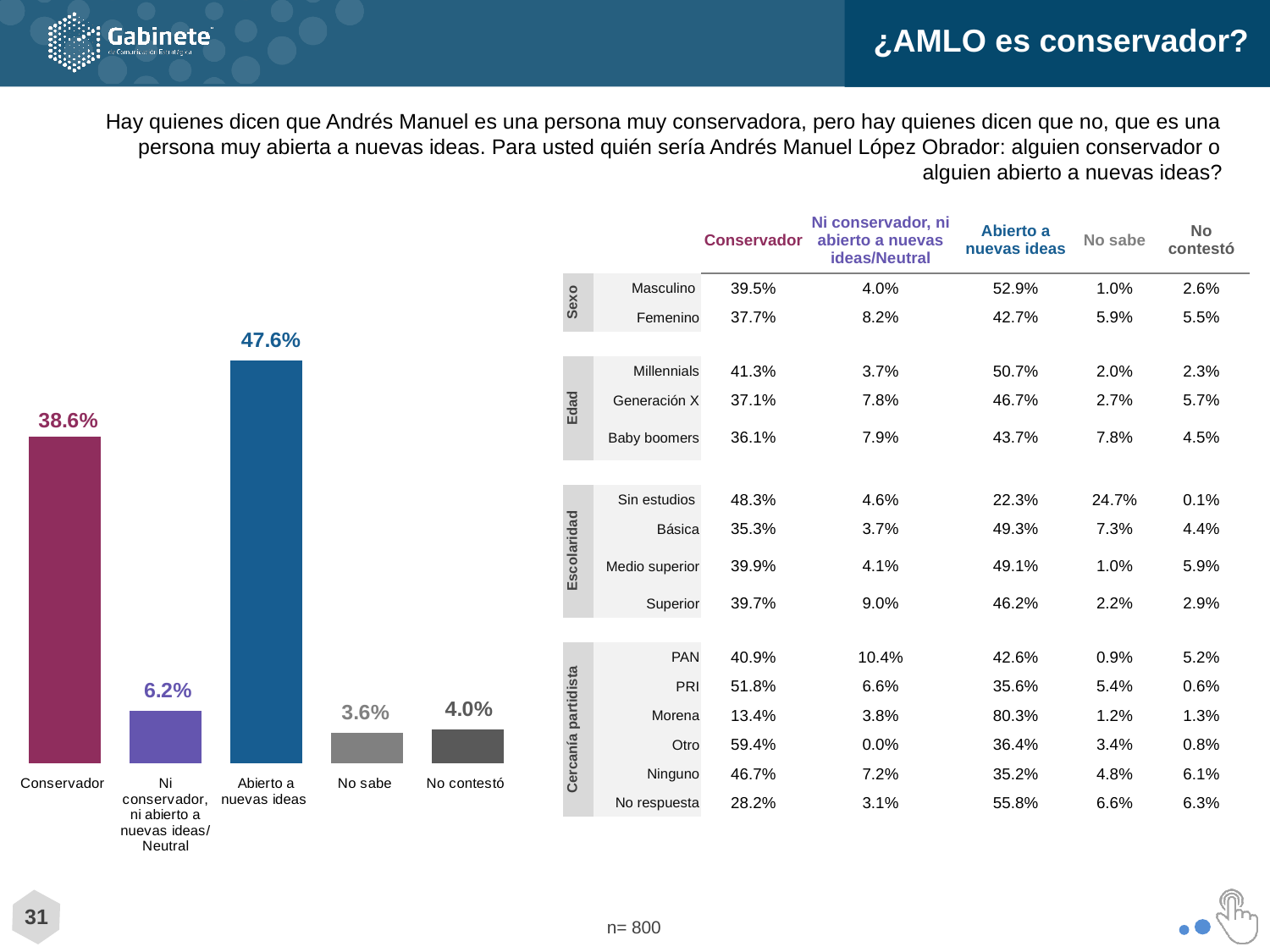
What is the value for Conservador in the bar chart? 38.6% Which category has the highest value in the bar chart? Abierto a nuevas ideas Which is larger in the bar chart: Conservador or Ni conservador, ni abierto a nuevas ideas/Neutral? Conservador How many categories are shown in the bar chart? 5 What kind of chart is shown on the slide? Bar chart Which category has the lowest value in the bar chart? No sabe What is the value for No sabe in the bar chart? 3.6% What is the difference between No contestó and No sabe in the bar chart? 0.4% What is the difference between Abierto a nuevas ideas and Conservador in the bar chart? 9.0% What colour is the bar for Abierto a nuevas ideas in the bar chart? Blue What is the value for Abierto a nuevas ideas in the bar chart? 47.6% What is the value for No contestó in the bar chart? 4.0%